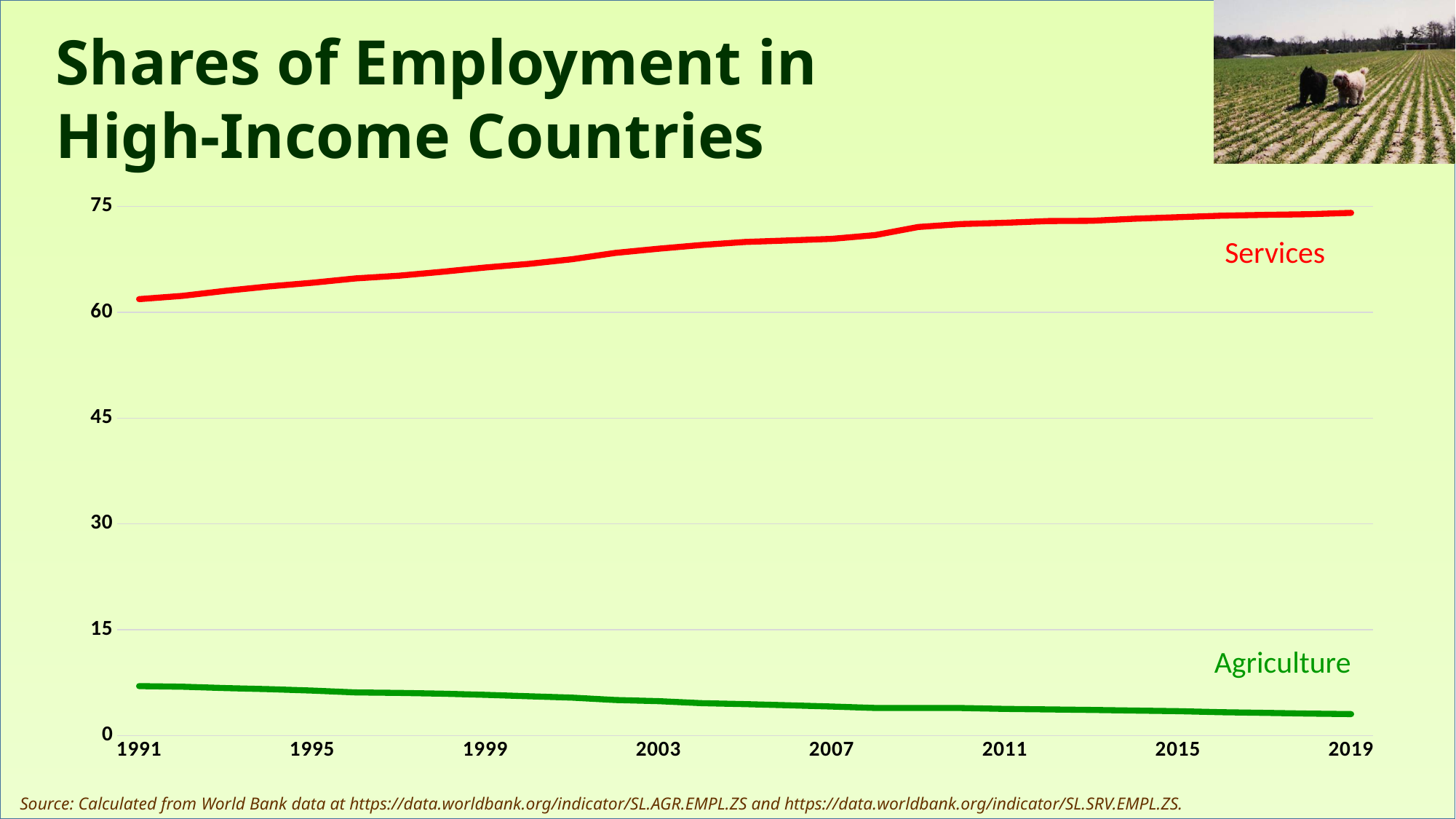
How many series are plotted on the chart? 2 Is the value for Agriculture in 1991 greater or less than 15? less Is the value for Services in 1991 greater or less than 60? greater Which series has the higher value in 2019, Services or Agriculture? Services What is the title of the chart on the slide? Shares of Employment in High-Income Countries Which series is drawn in red? Services How many year labels are shown on the x axis? 8 What kind of chart is shown on the slide? Line chart Does the Agriculture line rise or fall from 1991 to 2019? Falls Does the Services line rise or fall from 1991 to 2019? Rises Is the value for Agriculture in 2019 greater or less than 15? less